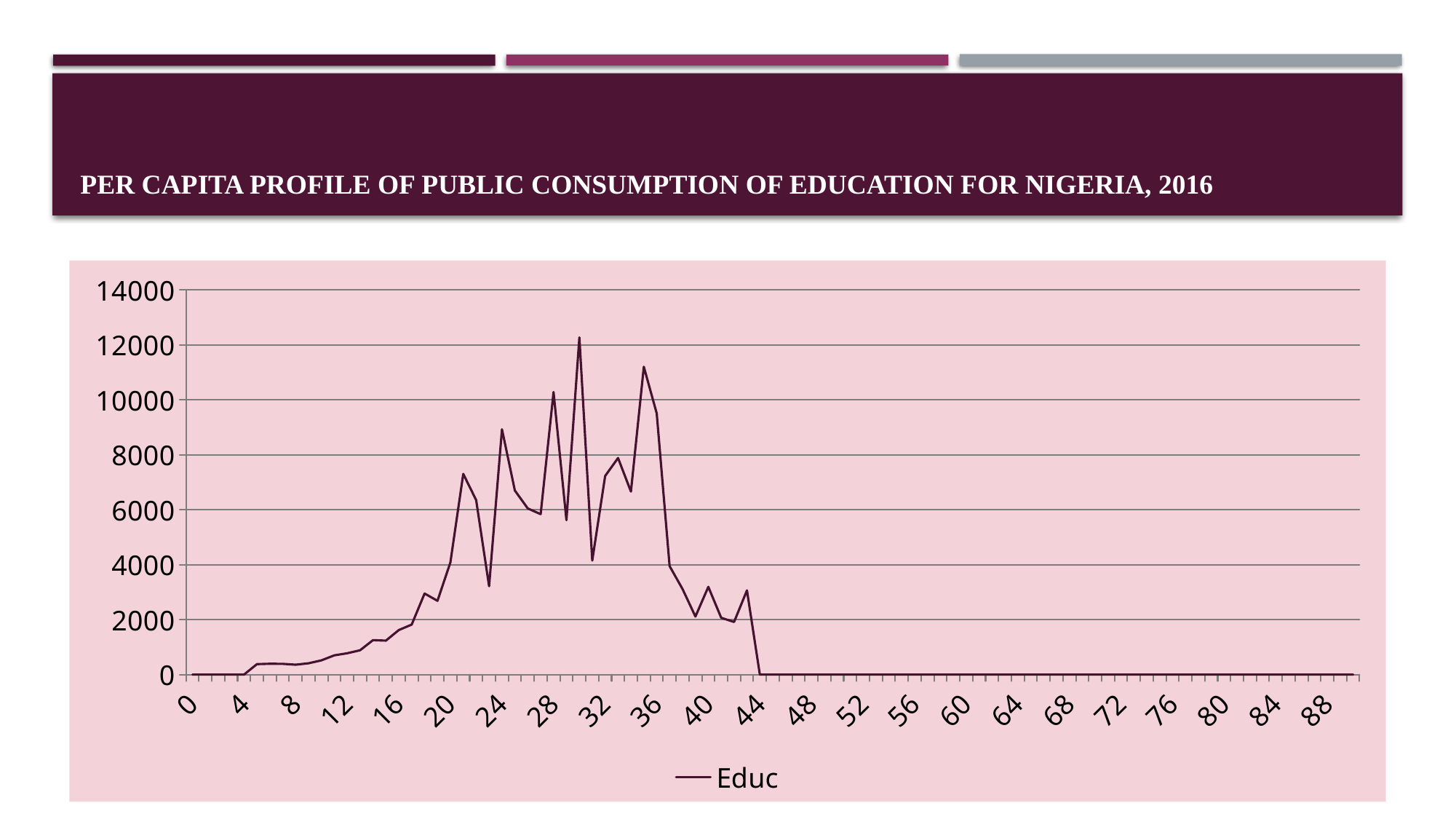
Does the Educ line generally rise or fall between age 0 and age 20? rise How many series does the legend list? 1 Is the value for Educ at age 30 greater or less than 10000? greater Which is larger, the value for Educ at age 36 or at age 24? age 36 What is the title of the chart? PER CAPITA PROFILE OF PUBLIC CONSUMPTION OF EDUCATION FOR NIGERIA, 2016 Is the value for Educ at age 8 greater or less than 2000? less What is the value for Educ at age 60? 0 Is the value for Educ at age 36 greater or less than 10000? less What kind of chart is shown on the slide? line chart What is the highest value shown on the vertical axis? 14000 What is the name of the series shown in the legend? Educ